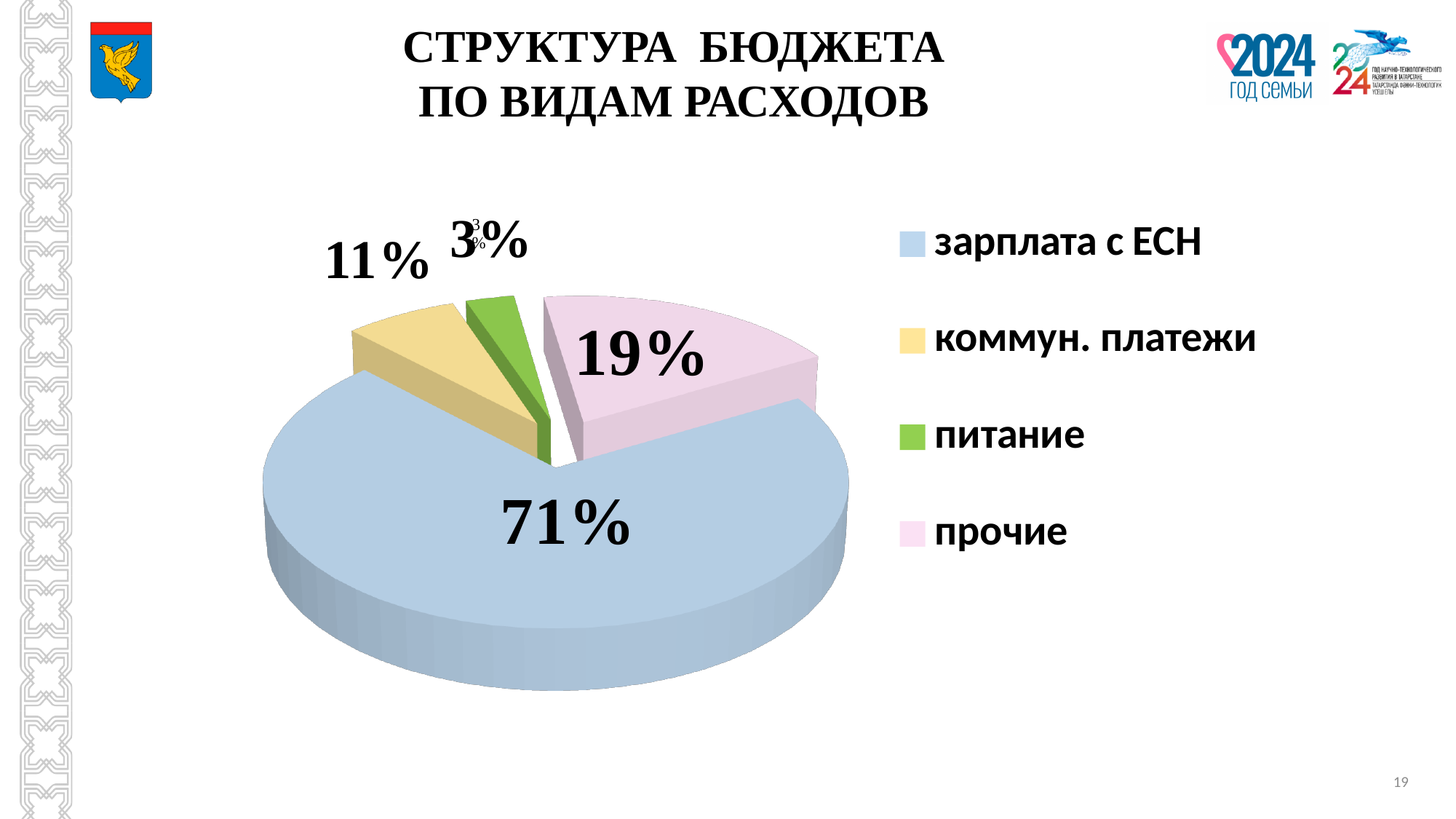
What share of the budget goes to прочие? 19% Which expense category has the largest share of the budget? зарплата с ЕСН What is the difference in percentage points between коммун. платежи and питание? 8 How many expense categories are shown in the pie chart? 4 What share of the budget goes to питание? 3% What is the difference in percentage points between зарплата с ЕСН and прочие? 52 Which expense category has the smallest share of the budget? питание What share of the budget goes to зарплата с ЕСН? 71% What type of chart is shown on the slide? pie chart Which is larger, the share for прочие or the share for коммун. платежи? прочие What is the title of the chart on the slide? СТРУКТУРА БЮДЖЕТА ПО ВИДАМ РАСХОДОВ What share of the budget goes to коммун. платежи? 11%